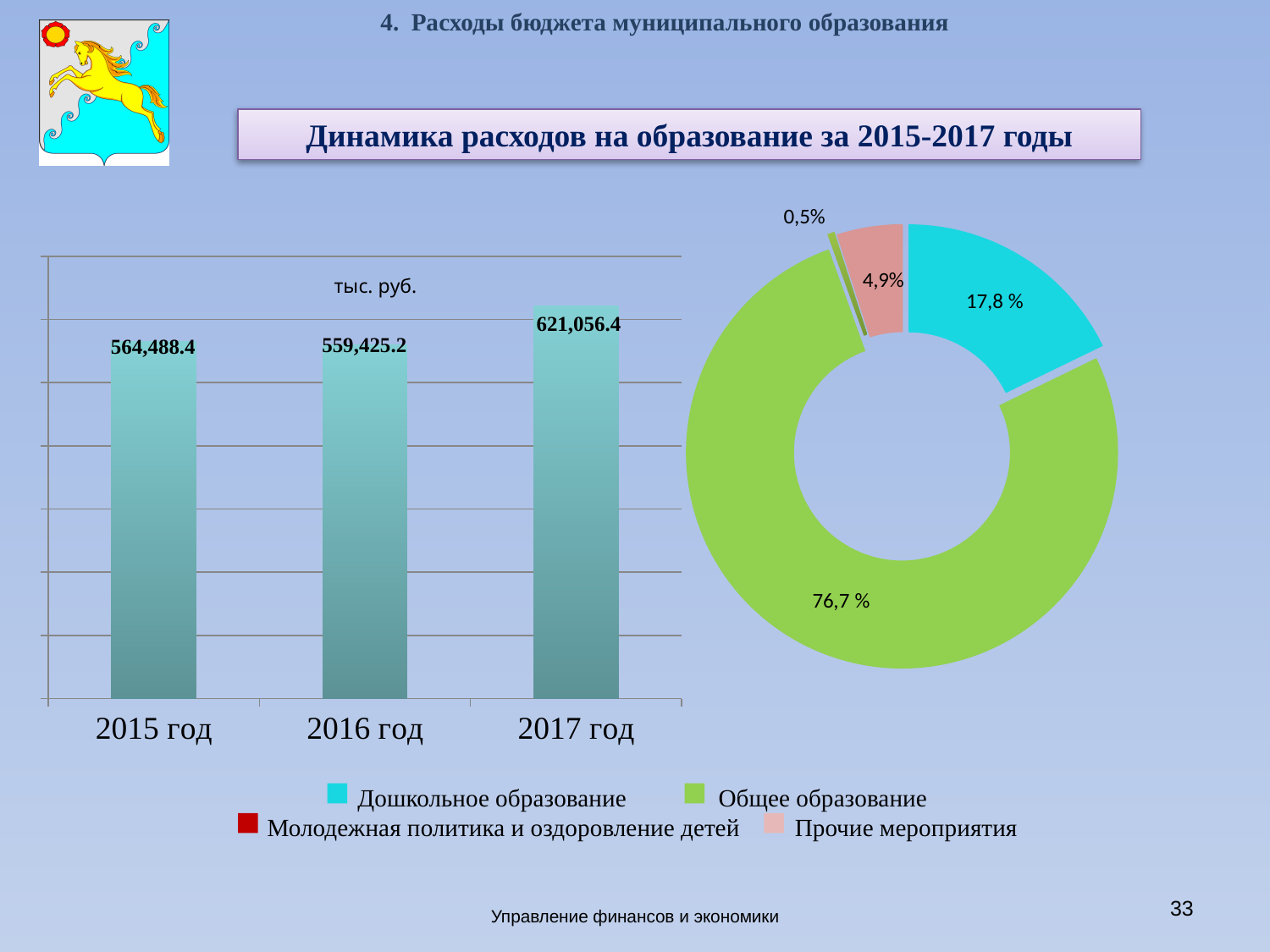
In the doughnut chart on the right, what share does Дошкольное образование have? 17,8 % In the bar chart on the left, what is the value for 2015 год? 564,488.4 How many bars are in the bar chart on the left? 3 In the bar chart on the left, which is larger: the value for 2015 год or for 2016 год? 2015 год In the bar chart on the left, what is the difference between the values for 2017 год and 2016 год? 61,631.2 In the bar chart on the left, what is the difference between the values for 2015 год and 2016 год? 5,063.2 In the bar chart on the left, what is the value for 2017 год? 621,056.4 In the doughnut chart on the right, what share does Общее образование have? 76,7 % In the bar chart on the left, which year has the highest value? 2017 год How many entries does the legend of the doughnut chart on the right list? 4 In the bar chart on the left, which year has the lowest value? 2016 год What kind of chart is the chart on the left? bar chart